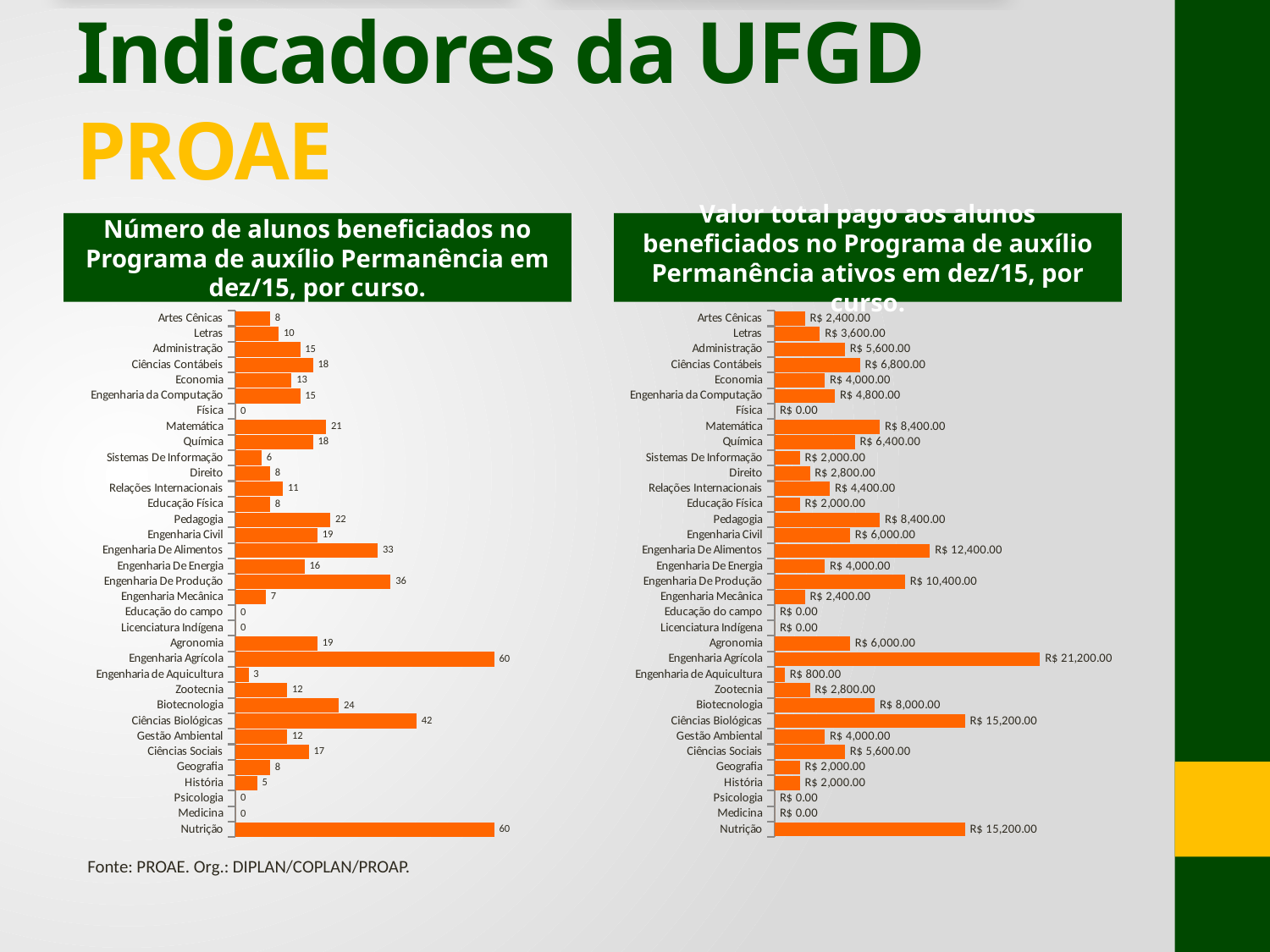
In the right chart (Valor total pago aos alunos), what is the difference between Engenharia Agrícola and Nutrição? R$ 6,000.00 In the left chart (Número de alunos beneficiados), which is larger, Pedagogia or Matemática? Pedagogia What type of chart is the right chart (Valor total pago aos alunos)? Bar chart In the right chart (Valor total pago aos alunos), which course has the highest value? Engenharia Agrícola In the right chart (Valor total pago aos alunos), which is larger, Ciências Contábeis or Química? Ciências Contábeis In the left chart (Número de alunos beneficiados), what is the value for Ciências Biológicas? 42 In the right chart (Valor total pago aos alunos), what is the value for Engenharia de Aquicultura? R$ 800.00 What is the source cited below the charts? PROAE. Org.: DIPLAN/COPLAN/PROAP. In the right chart (Valor total pago aos alunos), what is the value for Engenharia De Alimentos? R$ 12,400.00 In the left chart (Número de alunos beneficiados), what is the difference between Engenharia De Alimentos and Biotecnologia? 9 In the left chart (Número de alunos beneficiados), how many students are shown for Engenharia De Produção? 36 How many courses are listed in the left chart (Número de alunos beneficiados)? 34